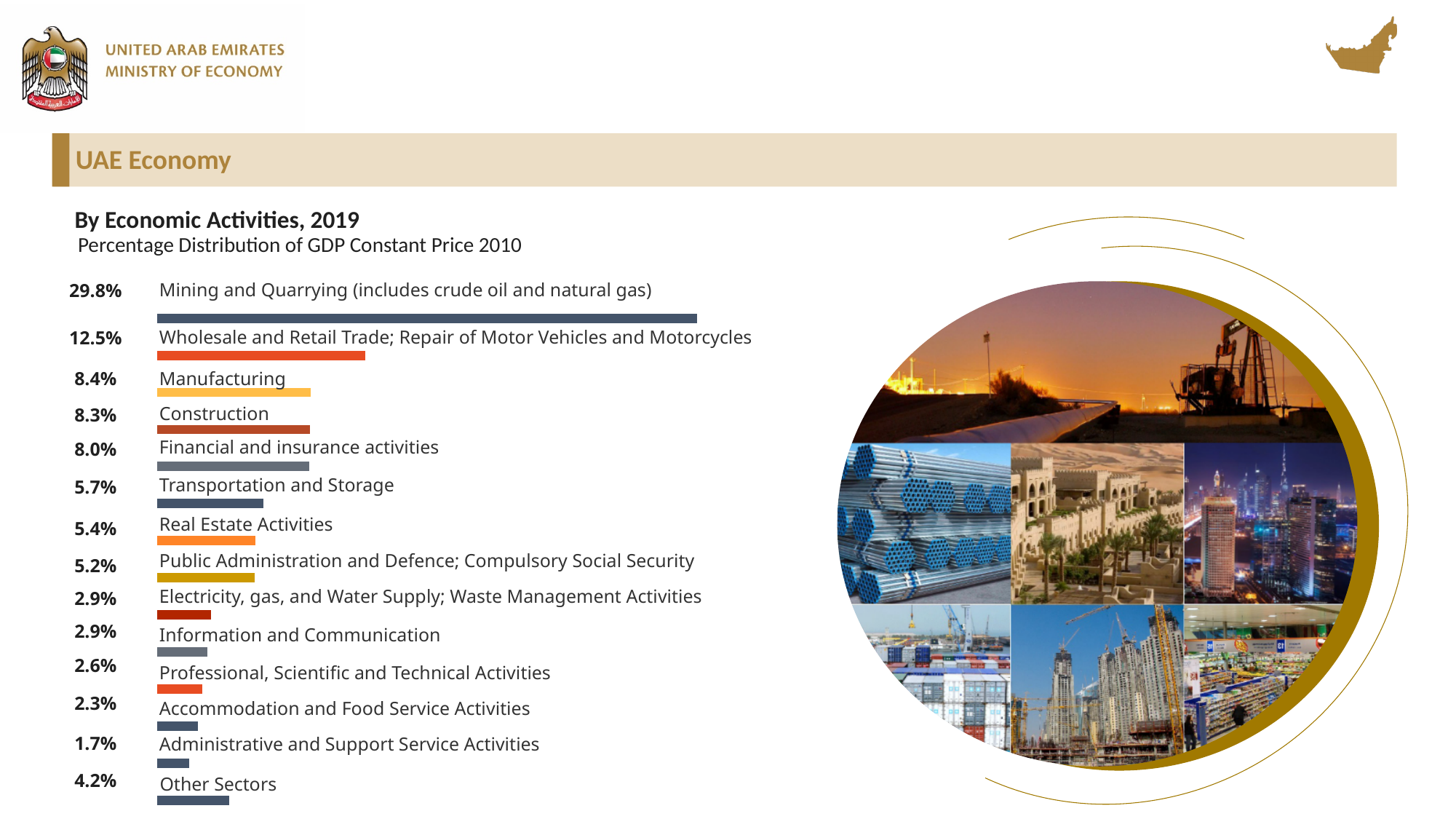
Which economic activity has the highest share of GDP? Mining and Quarrying (includes crude oil and natural gas) What kind of chart is used to show the percentage distribution of GDP? Bar chart What share is shown for Transportation and Storage? 5.7% How many economic activity categories are listed in the chart? 14 What percentage of GDP does Mining and Quarrying (includes crude oil and natural gas) account for? 29.8% What is the value shown for Wholesale and Retail Trade; Repair of Motor Vehicles and Motorcycles? 12.5% Which has a larger share: Manufacturing or Construction? Manufacturing What is the value for Other Sectors? 4.2% What is the difference in percentage points between Mining and Quarrying and Wholesale and Retail Trade? 17.3 What is the subtitle of the chart below 'By Economic Activities, 2019'? Percentage Distribution of GDP Constant Price 2010 Which has a larger share: Real Estate Activities or Public Administration and Defence; Compulsory Social Security? Real Estate Activities Which economic activity has the lowest share of GDP? Administrative and Support Service Activities